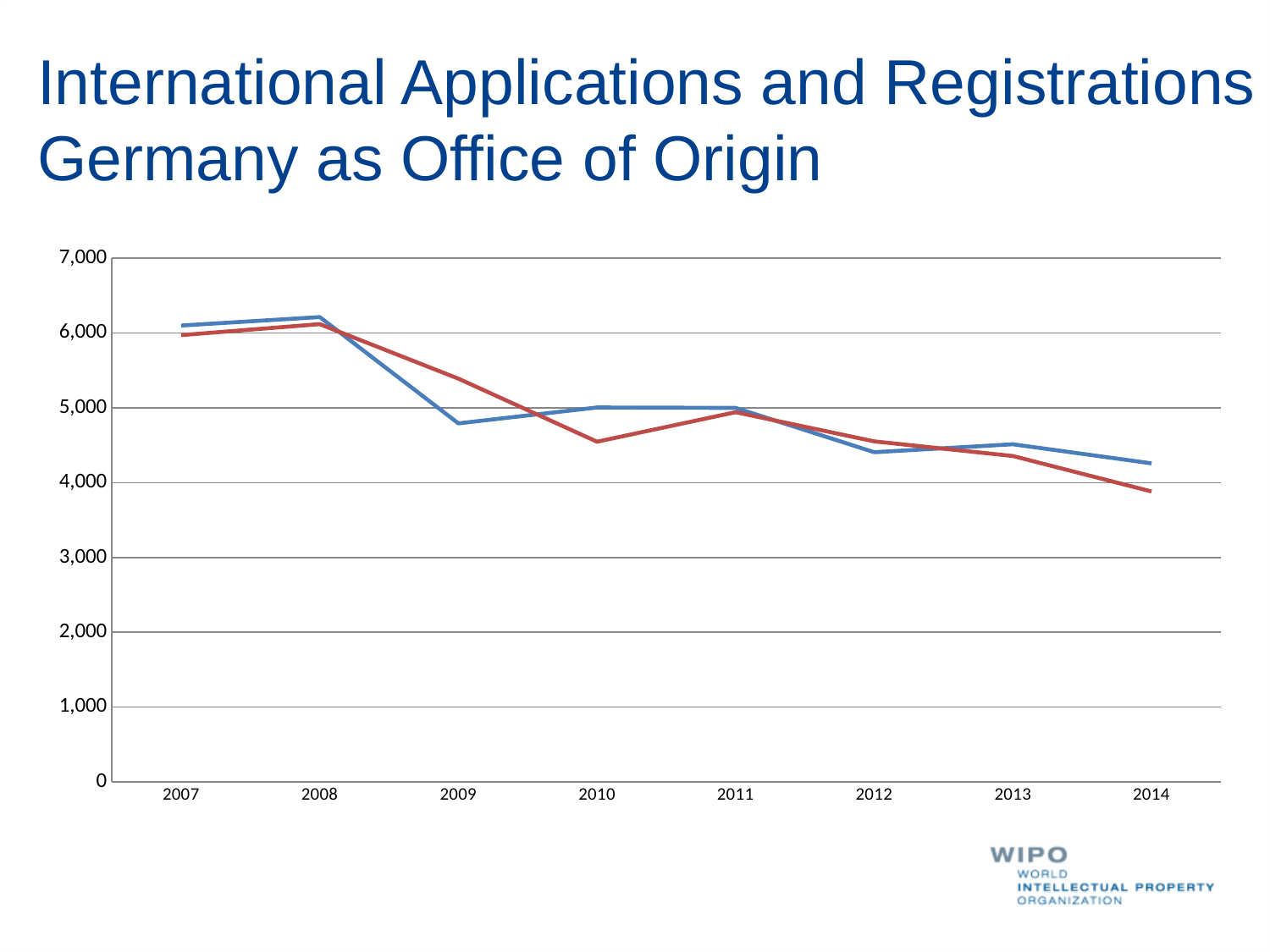
Is the value of the blue line in 2009 greater or less than 5,000? less How many years are plotted along the x axis? 8 How many lines are plotted on the chart? 2 Is the value of the red line in 2014 greater or less than 4,000? less What kind of chart is shown on the slide? line chart In which year does the blue line reach its highest value? 2008 In which year does the red line reach its lowest value? 2014 What is the overall trend of the red line from 2007 to 2014? falling In 2010, which line has the higher value, the blue line or the red line? blue line Is the value of the blue line in 2007 greater or less than 6,000? greater What is the overall trend of the blue line from 2007 to 2014? falling In 2009, which line has the higher value, the blue line or the red line? red line